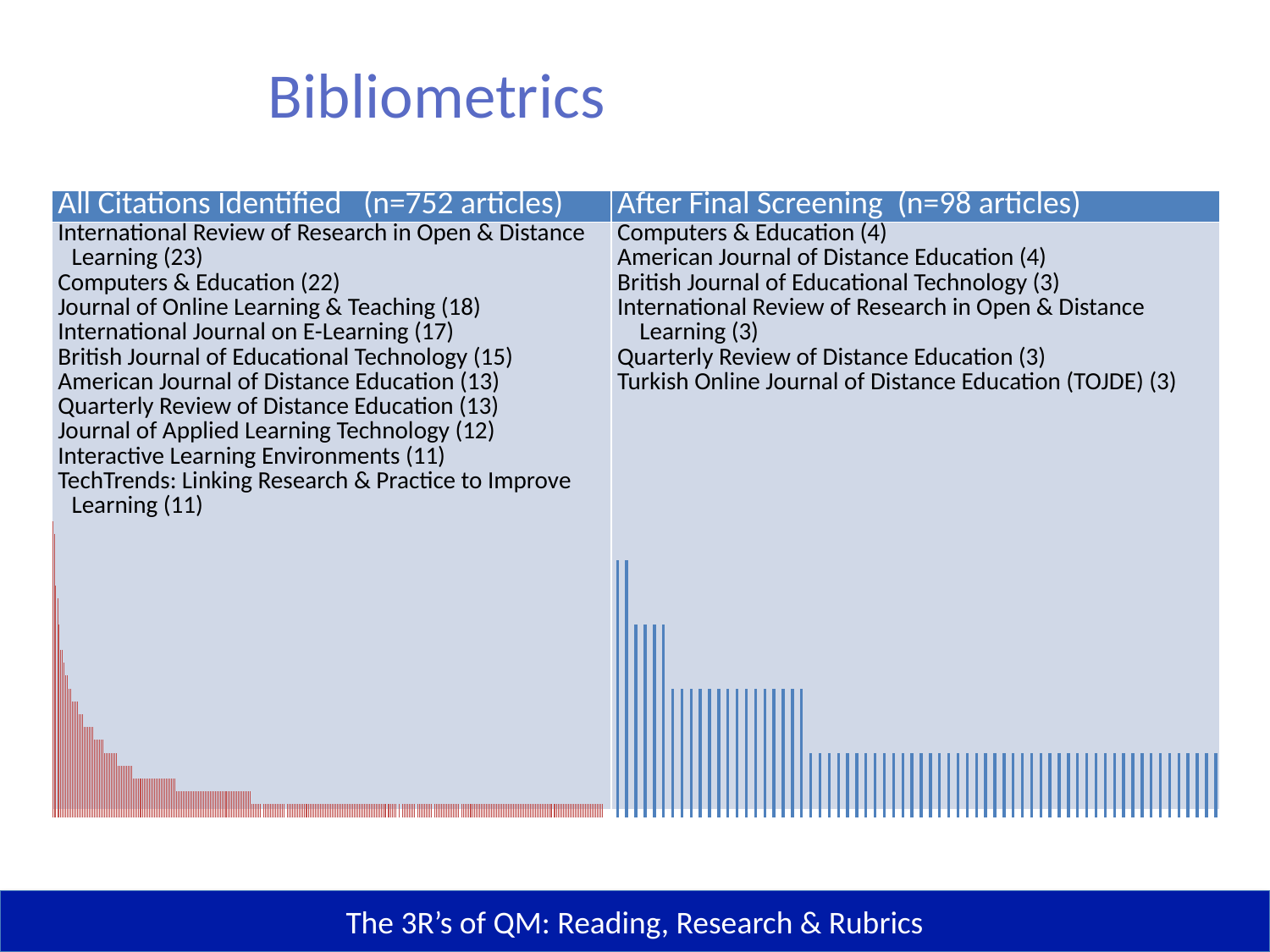
What kind of chart is shown under the 'After Final Screening' heading on the right? bar chart What is the heading above the left chart? All Citations Identified (n=752 articles) In the left chart (All Citations Identified), do the bar heights rise or fall from left to right? fall In the 'All Citations Identified' list, which has more articles: Journal of Online Learning & Teaching or International Journal on E-Learning? Journal of Online Learning & Teaching In the 'All Citations Identified' list, which journal has the highest number of articles? International Review of Research in Open & Distance Learning How many more articles does Computers & Education have in the 'All Citations Identified' list than in the 'After Final Screening' list? 18 In the 'After Final Screening' list, how many articles are attributed to Computers & Education? 4 What is the heading above the right chart? After Final Screening (n=98 articles) What kind of chart is shown under the 'All Citations Identified' heading on the left? bar chart How many journals are listed in the 'After Final Screening' list? 6 In the right chart (After Final Screening), do the bar heights rise or fall from left to right? fall In the 'All Citations Identified' list, how many articles are attributed to Computers & Education? 22